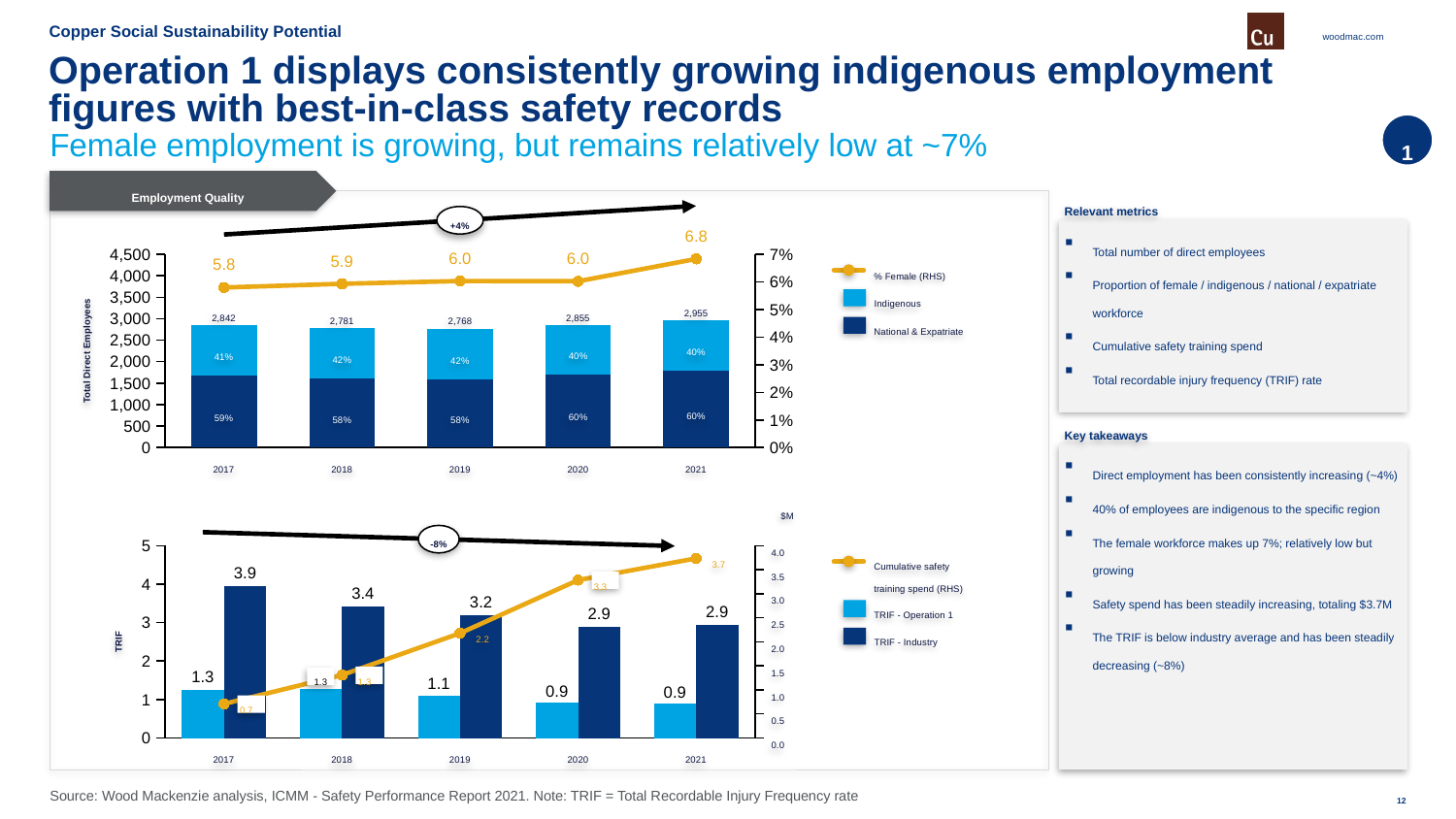
In the top chart, what is the total number of direct employees in 2021? 2,955 In the top chart, what is the % Female value for 2021? 6.8 In the top chart, which year has the lowest total number of direct employees? 2019 In the bottom chart, what is the cumulative safety training spend in 2021? 3.7 In the top chart, what percentage of employees were indigenous in 2018? 42% In the bottom chart, what is the TRIF - Operation 1 value for 2020? 0.9 In the top chart, what is the difference in total direct employees between 2021 and 2017? 113 In the bottom chart, what is the TRIF - Industry value for 2017? 3.9 In the bottom chart, which is larger in 2019: TRIF - Operation 1 or TRIF - Industry? TRIF - Industry In the bottom chart, does the TRIF - Industry value rise or fall from 2017 to 2021? fall How many series does the legend of the top chart list? 3 How many years are shown on the x axis of the bottom chart? 5